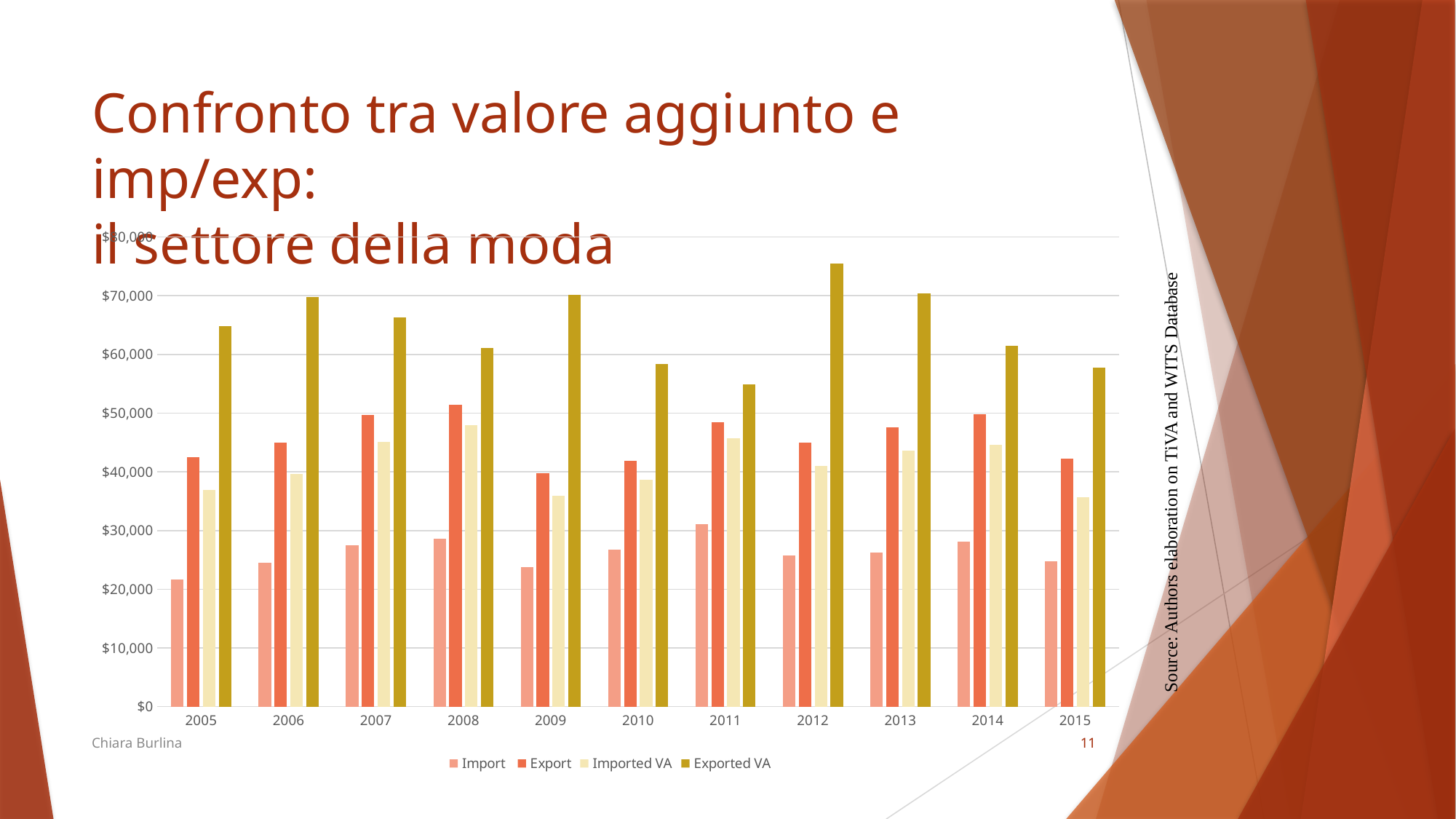
What kind of chart is shown on the slide? Bar chart How many series does the chart legend list? 4 How many years are shown on the x axis of the chart? 11 Is the Exported VA value for 2012 greater or less than $70,000? greater In which year is the Import value highest? 2011 In which year is the Import value lowest? 2005 In which year is the Exported VA value highest? 2012 Which series is shown in the darkest gold colour in the legend? Exported VA Which is larger in 2010, the Export value or the Imported VA value? Export In which year is the Export value lowest? 2009 Is the Import value for 2011 greater or less than $30,000? greater